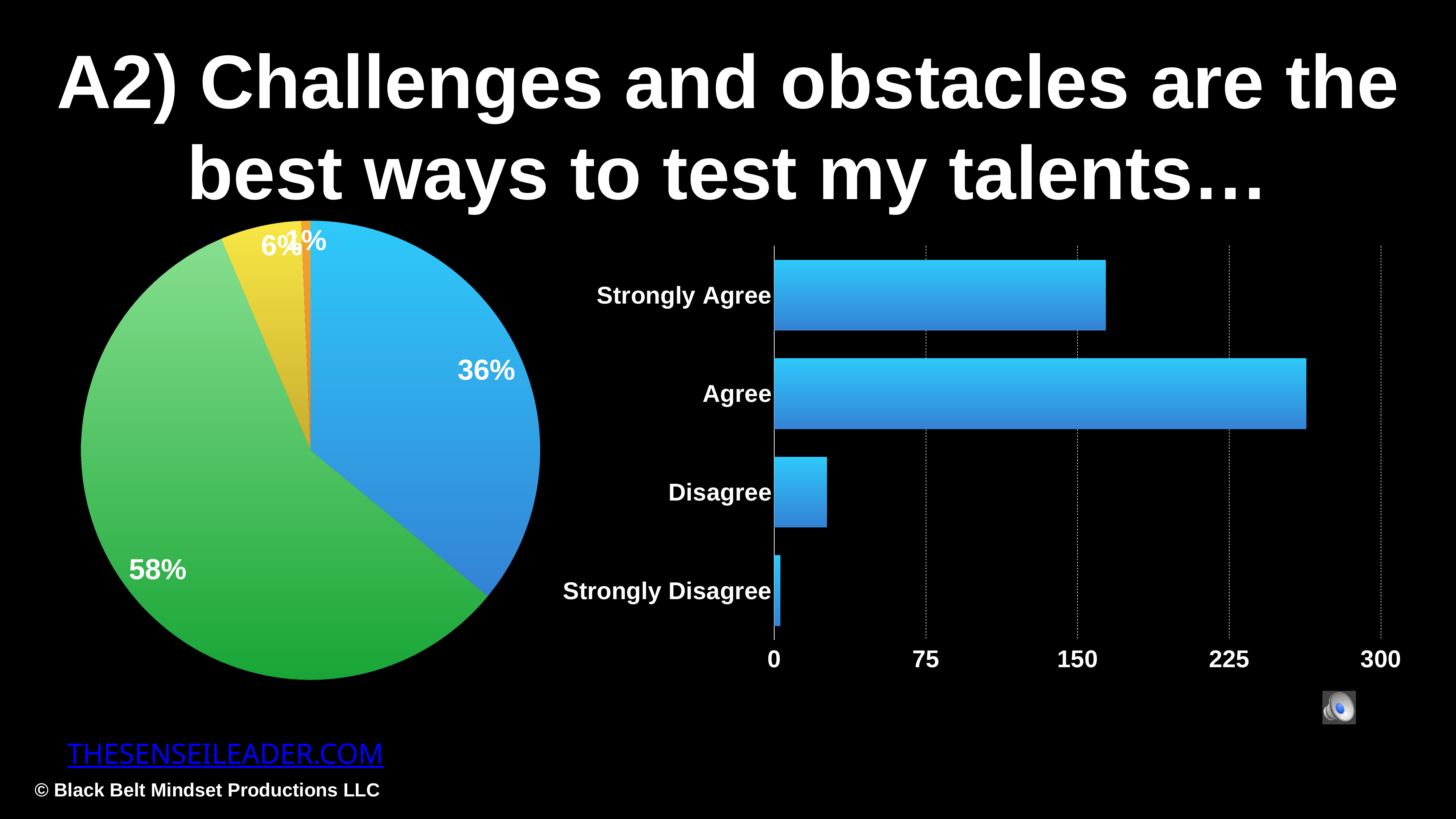
How many categories are shown in the bar chart on the right? 4 In the pie chart on the left, what share is shown on the blue slice? 36% What kind of chart is on the left side of the slide? pie chart In the bar chart on the right, is the value for Strongly Agree greater or less than 150? greater In the bar chart on the right, which category has the shortest bar? Strongly Disagree In the pie chart on the left, what is the largest slice's share? 58% In the bar chart on the right, which category has the longest bar? Agree In the bar chart on the right, is the value for Agree greater or less than 225? greater How many slices does the pie chart on the left have? 4 In the bar chart on the right, which is larger, the value for Agree or the value for Strongly Agree? Agree What kind of chart is on the right side of the slide? bar chart In the bar chart on the right, is the value for Disagree greater or less than 75? less